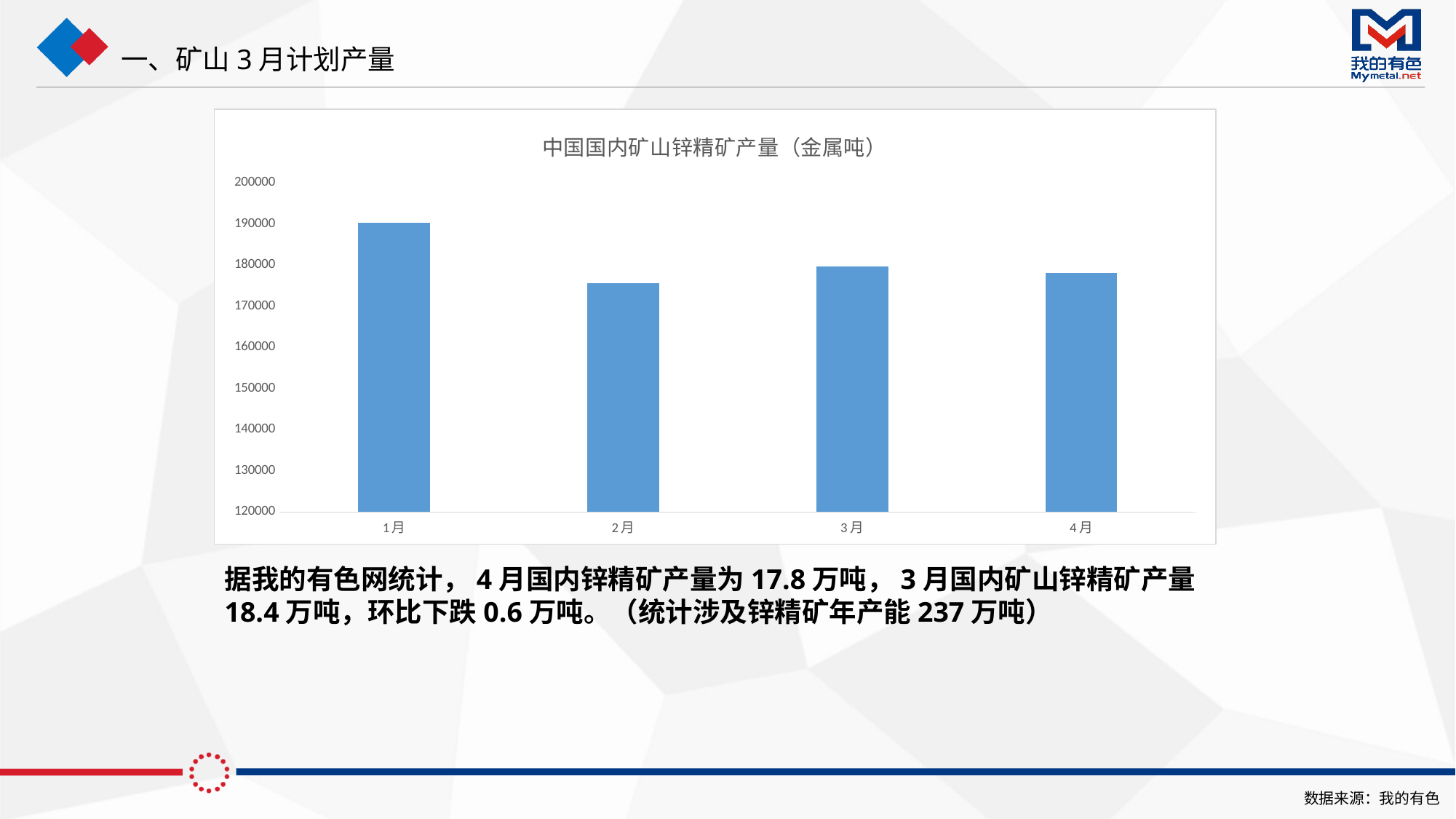
Which month has the lowest zinc concentrate output in the chart? 2月 Which is larger, the value for 1月 or the value for 2月? 1月 What kind of chart is shown on the slide? bar chart Is the value for 2月 greater or less than 170000? greater Which month has the highest zinc concentrate output in the chart? 1月 Is the value for 2月 greater or less than 180000? less Which is larger, the value for 3月 or the value for 2月? 3月 What is the title of the chart? 中国国内矿山锌精矿产量（金属吨） Is the value for 4月 greater or less than 180000? less Does the value rise or fall from 1月 to 2月? fall How many months are plotted on the x axis of the chart? 4